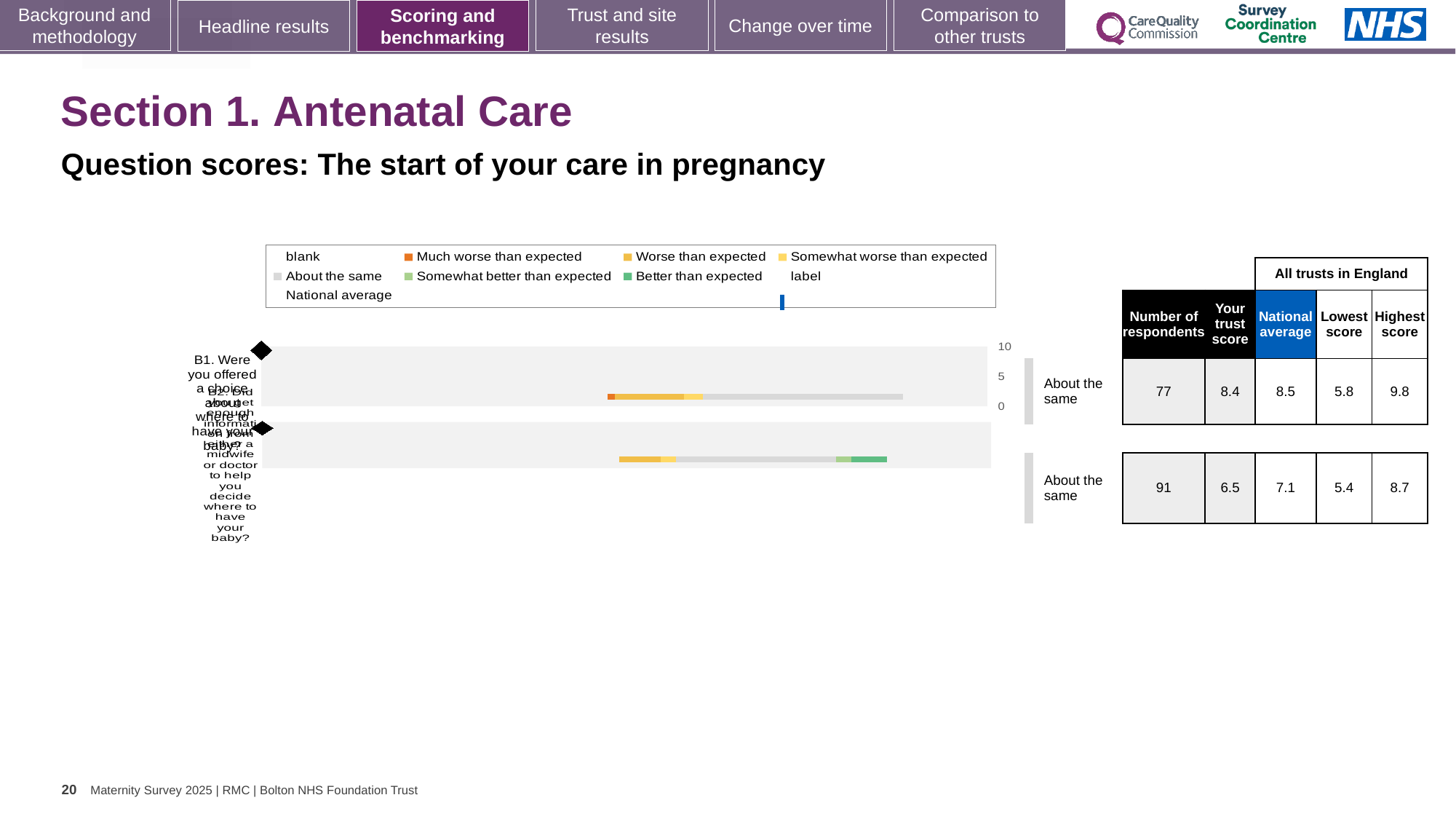
What is the 'Your trust score' for question B1 (Were you offered a choice about where to have your baby?)? 8.4 What kind of chart is shown on the slide? bar chart How many questions (categories) are plotted in the chart? 2 What is the lowest score among all trusts in England for question B2? 5.4 What is the number of respondents for question B2? 91 Which legend entry is shown in dark orange? Much worse than expected What is the highest score among all trusts in England for question B1? 9.8 What is the 'Your trust score' for question B2? 6.5 What is the national average for question B1? 8.5 Which question has the higher 'Your trust score', B1 or B2? B1 What is the difference between the national average and the trust score for question B2? 0.6 What is the title of the chart section shown above the chart? Question scores: The start of your care in pregnancy